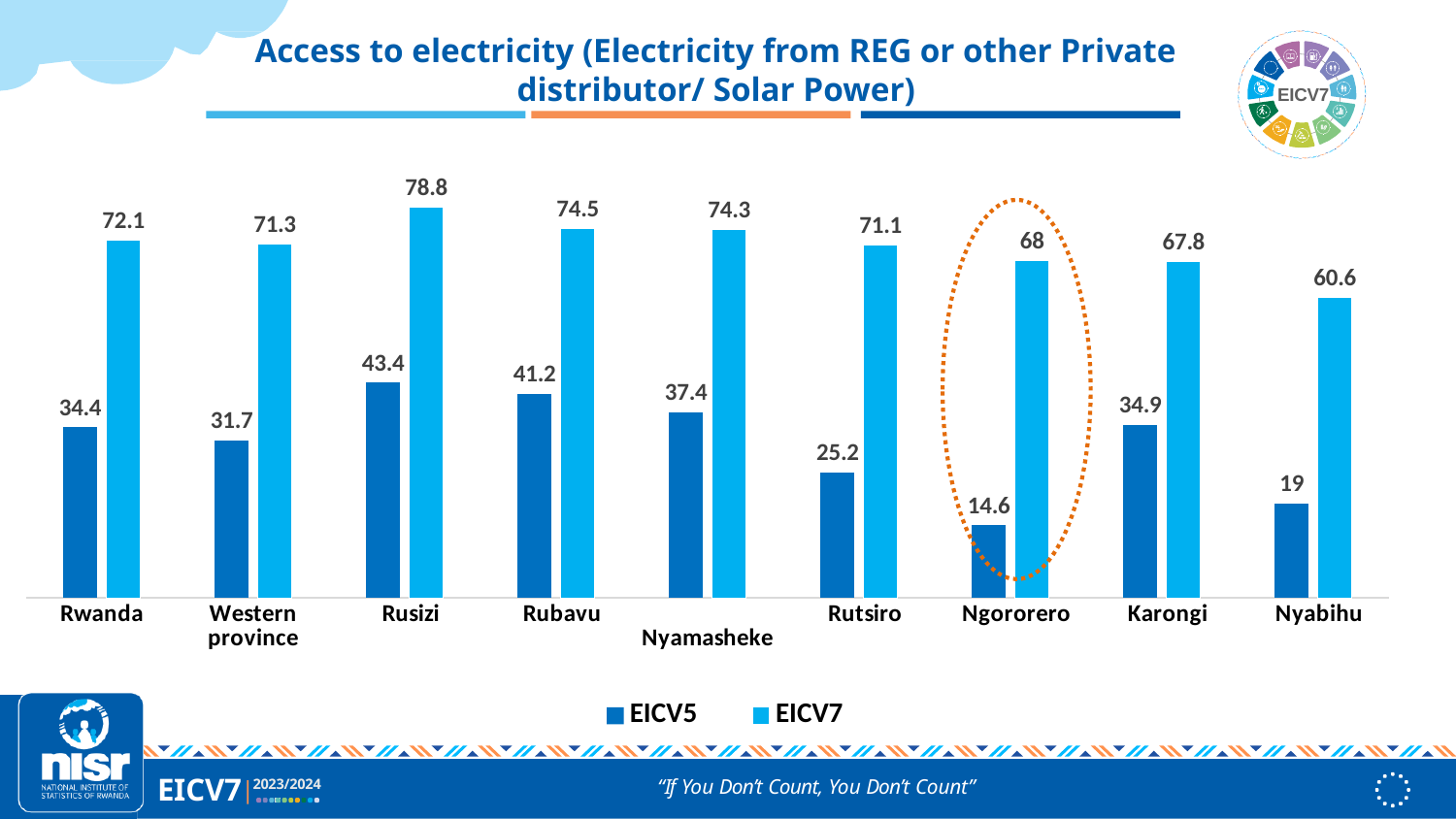
What is the EICV7 value for Nyabihu? 60.6 What kind of chart is shown on the slide? Bar chart Which is larger, the EICV5 value for Rusizi or the EICV5 value for Rubavu? Rusizi How many categories are shown on the x axis? 9 What is the EICV5 value for Ngororero? 14.6 Which category has the lowest EICV5 value? Ngororero Which category has the highest EICV7 value? Rusizi What is the difference between the EICV7 and EICV5 values for Rwanda? 37.7 Which category is highlighted with a dotted orange circle? Ngororero What is the difference between the EICV7 values for Karongi and Nyabihu? 7.2 How many series does the legend list? 2 What is the EICV7 value for Rusizi? 78.8